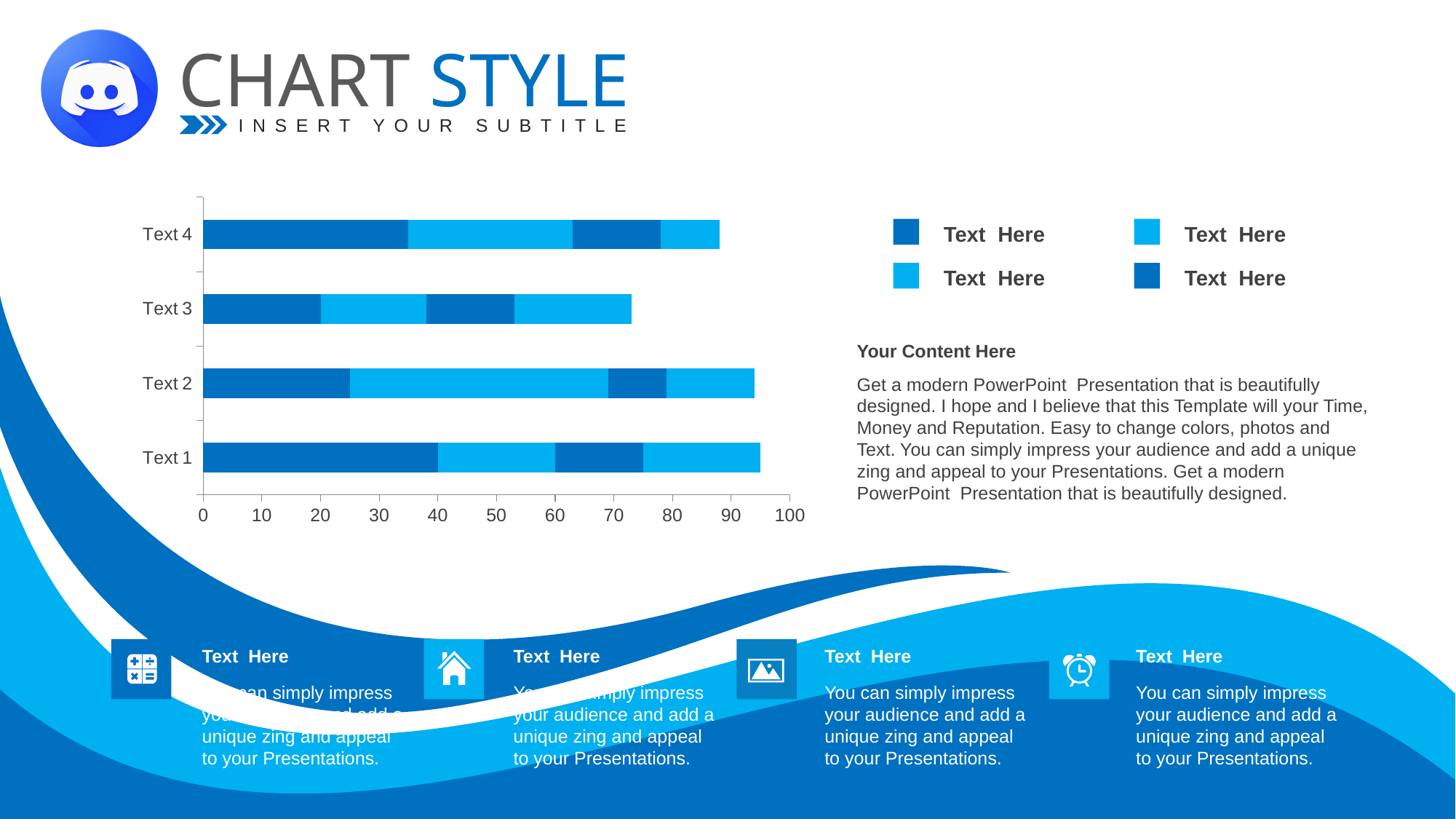
What kind of chart is shown on the slide? stacked bar chart Is the total bar length for Text 1 greater or less than 90? greater Is the leftmost (first) segment of the Text 3 bar greater or less than 30? less Is the total bar length for Text 4 greater or less than 80? greater How many series does the chart's legend list? 4 Which category has the lowest total bar length? Text 3 How many categories are plotted on the chart? 4 What is the maximum value shown on the chart's horizontal axis? 100 Which has the longer total bar, Text 1 or Text 3? Text 1 Which has the longer total bar, Text 4 or Text 3? Text 4